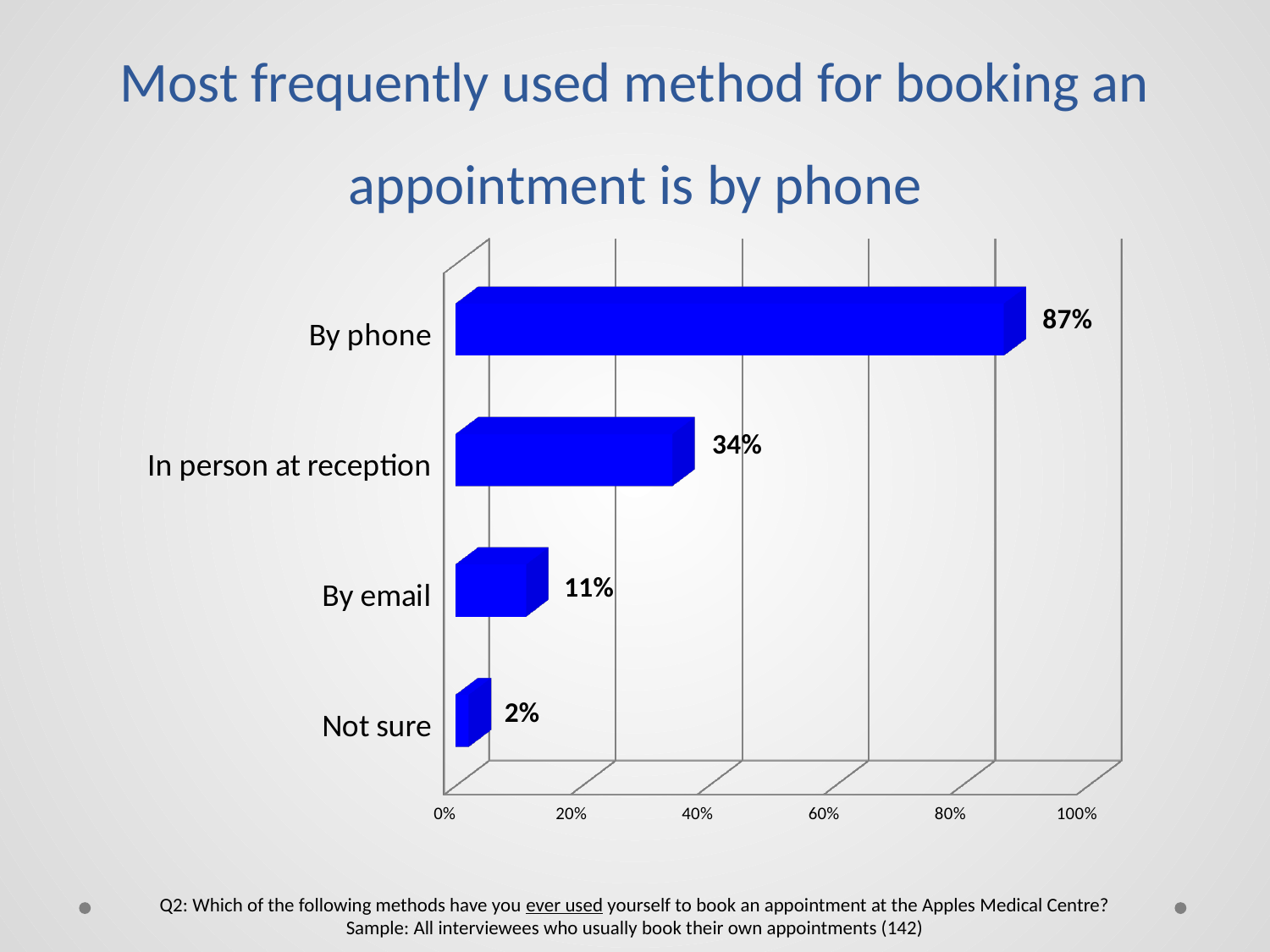
Which is larger, the value for 'By email' or the value for 'Not sure'? By email What kind of chart is shown on the slide? Bar chart What is the difference between the values for 'By phone' and 'In person at reception'? 53% What percentage is shown for 'By email'? 11% What is the difference between 'In person at reception' and 'By email'? 23% Which category has the lowest value? Not sure What is the maximum value shown on the horizontal axis? 100% What is the value for 'In person at reception'? 34% How many categories are shown in the chart? 4 What is the value for 'Not sure'? 2% Which booking method has the highest value? By phone What percentage of respondents book an appointment by phone? 87%